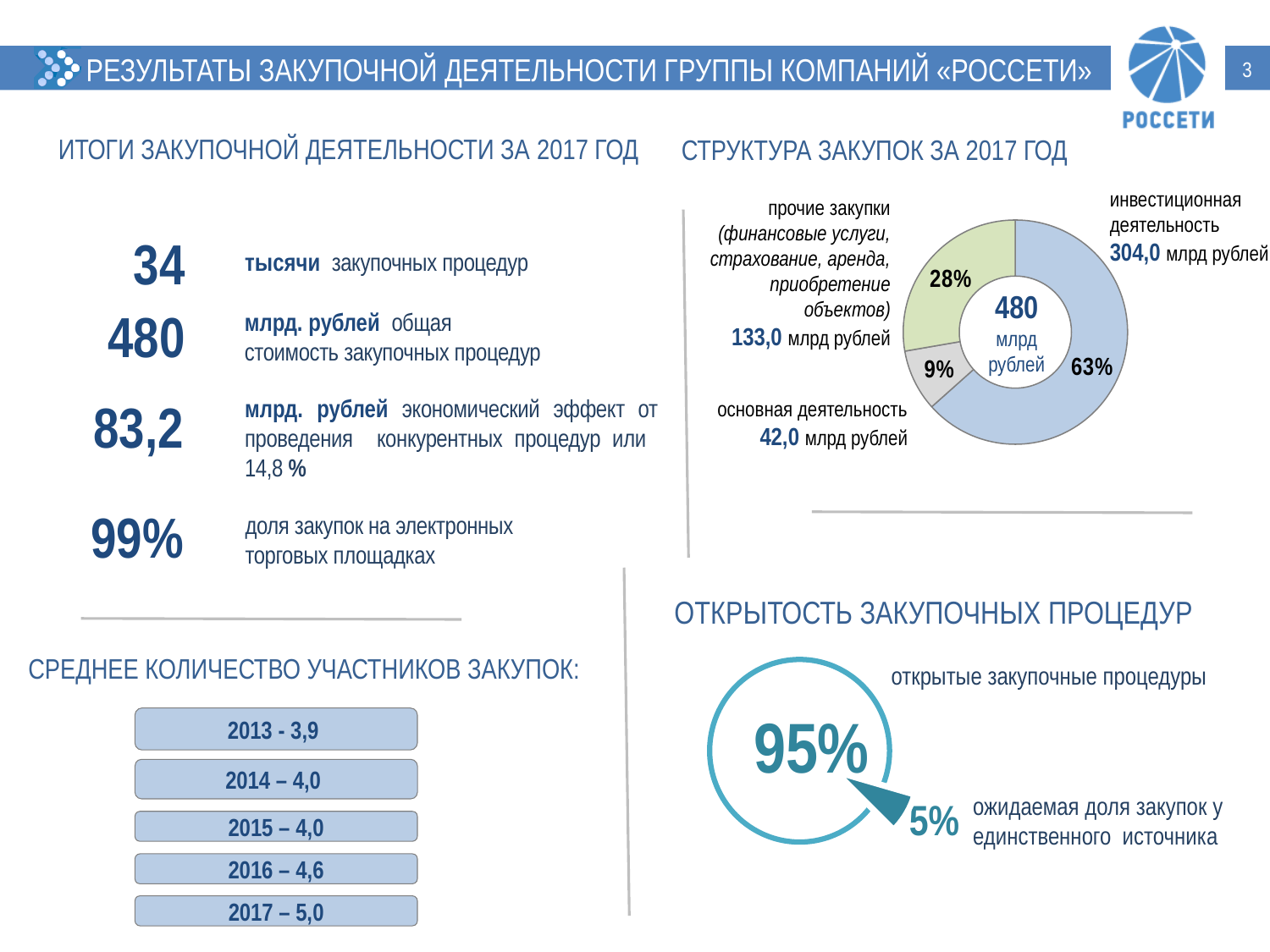
What total value is shown in the centre of the chart «Структура закупок за 2017 год»? 480 млрд рублей In the chart «Структура закупок за 2017 год», which category has the smallest value? основная деятельность In the chart «Структура закупок за 2017 год», what share of the total does «основная деятельность» represent? 9% In the chart «Структура закупок за 2017 год», what is the value for «прочие закупки»? 133,0 млрд рублей In the chart «Структура закупок за 2017 год», which category has the largest value? инвестиционная деятельность In the chart «Структура закупок за 2017 год», how many categories are shown? 3 In the chart «Структура закупок за 2017 год», what is the value for «основная деятельность»? 42,0 млрд рублей In the chart «Структура закупок за 2017 год», what share of the total does «инвестиционная деятельность» represent? 63% In the chart «Структура закупок за 2017 год», what is the difference between «инвестиционная деятельность» and «прочие закупки» in млрд рублей? 171,0 млрд рублей What type of chart is used for «Структура закупок за 2017 год»? Donut (pie) chart In the chart «Структура закупок за 2017 год», what is the value for «инвестиционная деятельность»? 304,0 млрд рублей In the chart «Структура закупок за 2017 год», what share of the total does «прочие закупки» represent? 28%